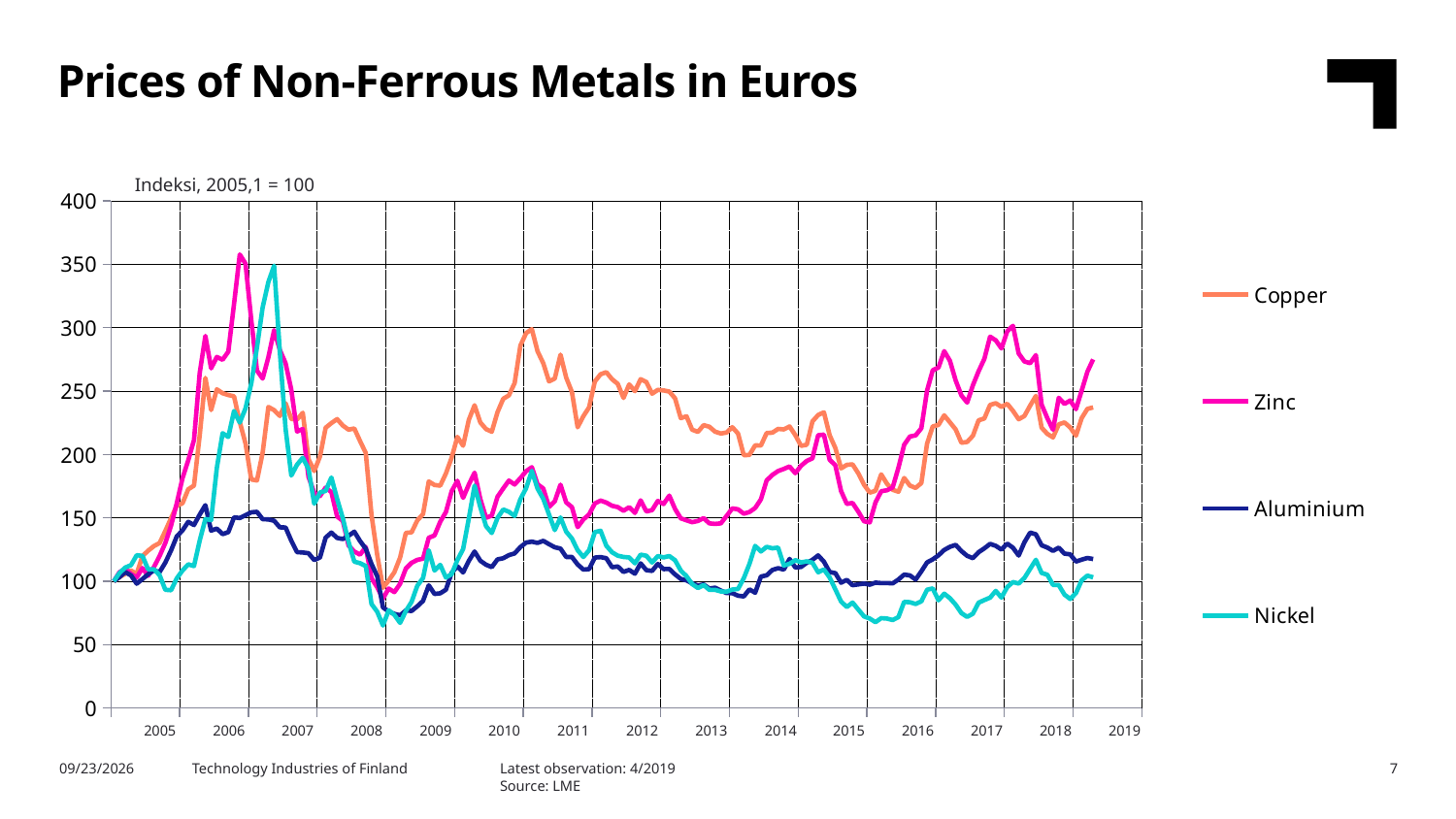
How many series does the legend list? 4 Does the Aluminium line ever rise above 200 on the index? No What is the base period of the index used in the chart? 2005,1 = 100 Does the Zinc line rise or fall between the start of 2016 and the start of 2018? Rise What kind of chart is shown on the slide? Line chart Which series is highest during 2012? Copper Is the peak value of Zinc in 2006 greater or less than 300? greater Which series has the lowest peak value over the whole period? Aluminium Is the peak value of Nickel in 2006 greater or less than 300? less Which metals are listed in the chart legend? Copper, Zinc, Aluminium, Nickel At the end of the series in 2019, which is higher, Zinc or Copper? Zinc